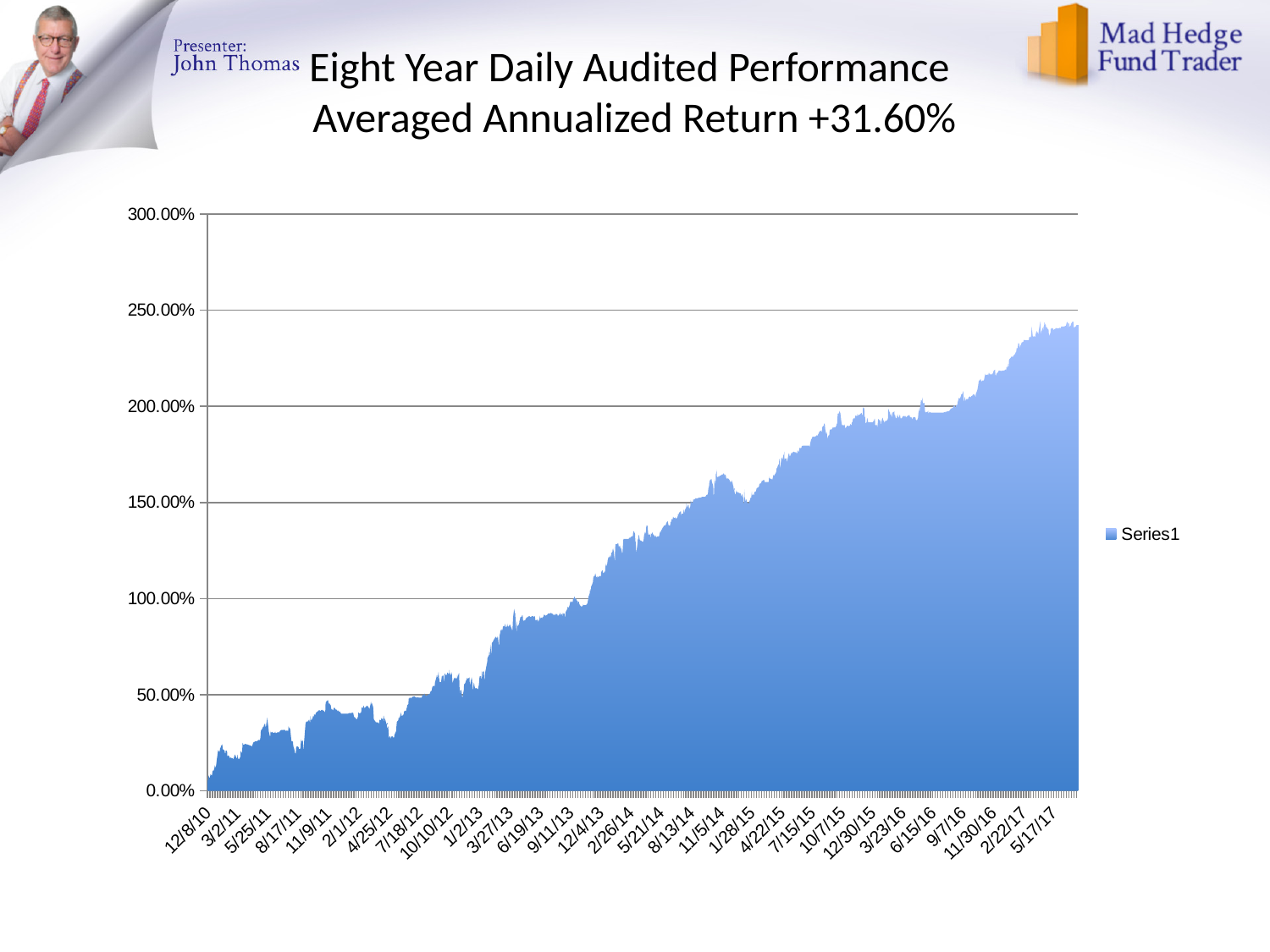
Is the value at 6/19/13 greater or less than 100.00%? less Is the value at 12/8/10 greater or less than 50.00%? less What kind of chart is shown on the slide? area chart Do the values generally rise or fall from 12/8/10 to 5/17/17? rise Is the value at 10/7/15 greater or less than 150.00%? greater What averaged annualized return is stated in the chart title? +31.60% What is the name of the series shown in the legend? Series1 How many series does the legend list? 1